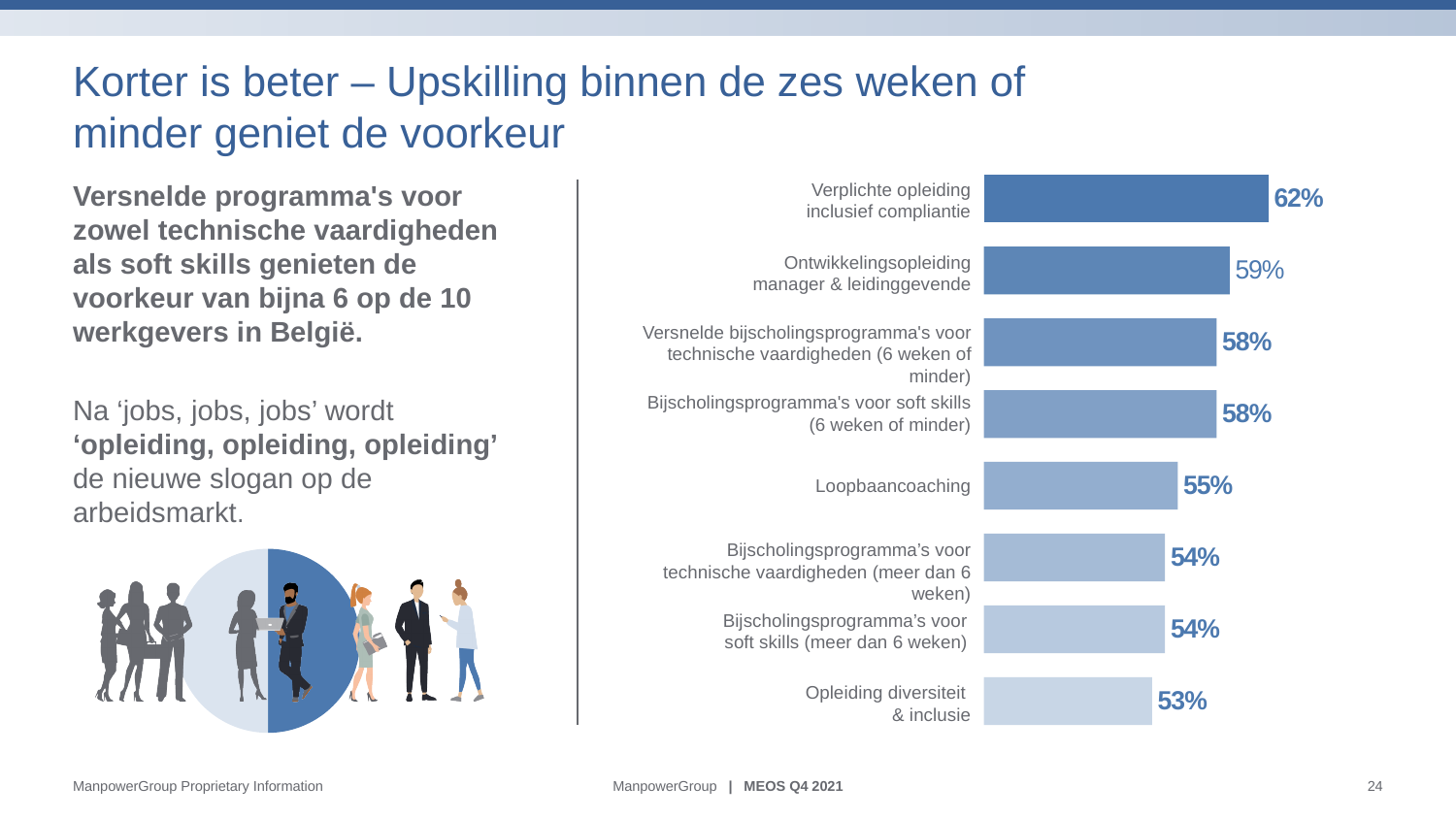
What is the difference between 'Ontwikkelingsopleiding manager & leidinggevende' and 'Loopbaancoaching'? 4 percentage points How many categories are shown in the chart? 8 Which is larger: 'Loopbaancoaching' or 'Bijscholingsprogramma's voor soft skills (meer dan 6 weken)'? Loopbaancoaching What is the value for 'Loopbaancoaching'? 55% What is the difference between 'Verplichte opleiding inclusief compliantie' and 'Opleiding diversiteit & inclusie'? 9 percentage points What is the value for 'Verplichte opleiding inclusief compliantie'? 62% Do the values rise or fall from the top bar to the bottom bar? Fall What kind of chart is shown on the slide? Bar chart What is the value for 'Opleiding diversiteit & inclusie'? 53% Which category has the lowest value? Opleiding diversiteit & inclusie Which category has the highest value? Verplichte opleiding inclusief compliantie What is the value for 'Ontwikkelingsopleiding manager & leidinggevende'? 59%